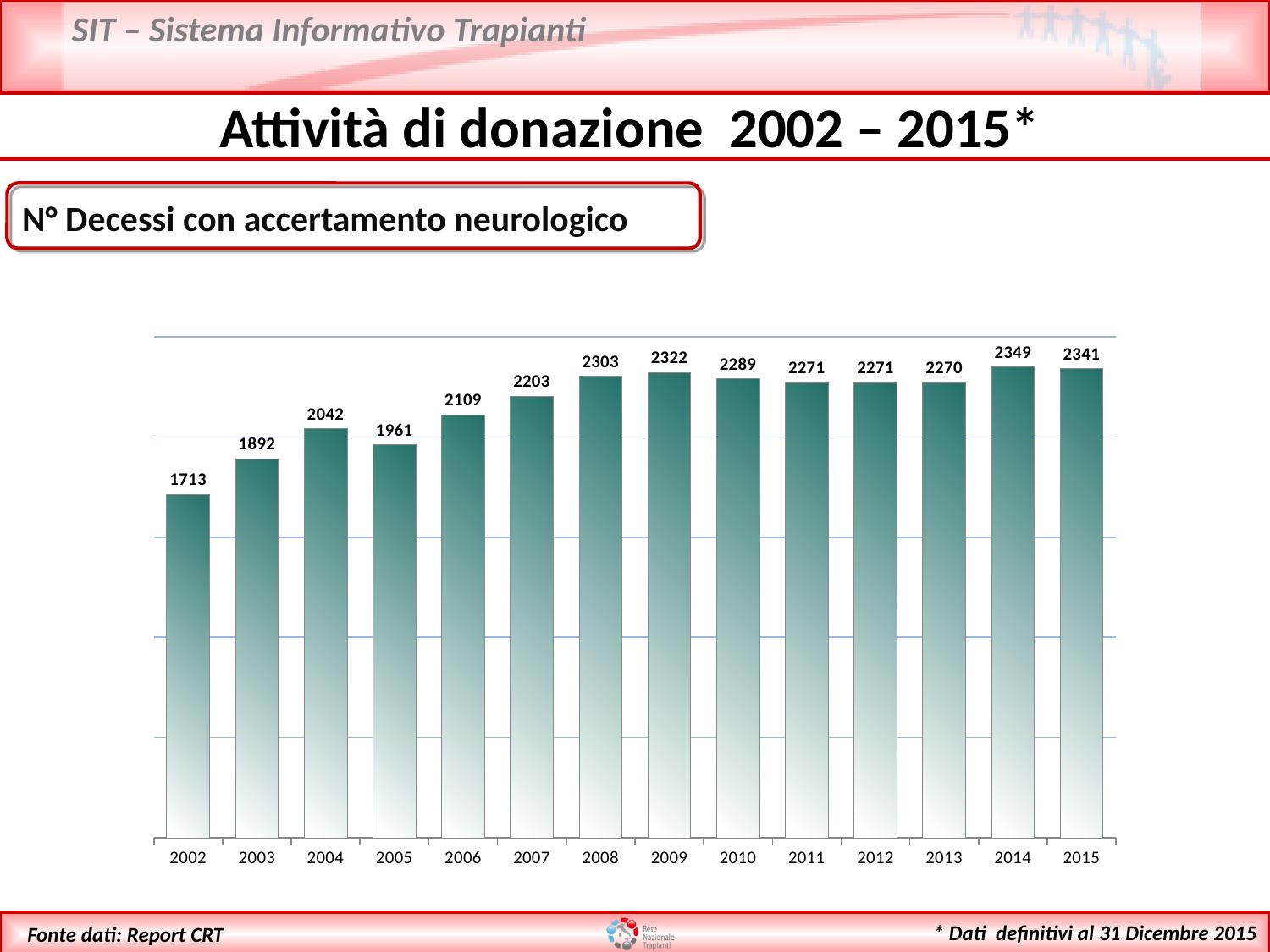
Which year has the lowest value? 2002 What is the title shown in the box above the chart? N° Decessi con accertamento neurologico Which is larger, the value for 2008 or the value for 2010? 2008 Which year has the highest value? 2014 What is the value for 2002? 1713 What is the value for 2015? 2341 How many years are shown on the x axis? 14 What is the value for 2009? 2322 What is the difference between the values for 2004 and 2005? 81 What is the difference between the values for 2014 and 2002? 636 Do the values generally rise or fall from 2002 to 2009? rise What kind of chart is shown? bar chart